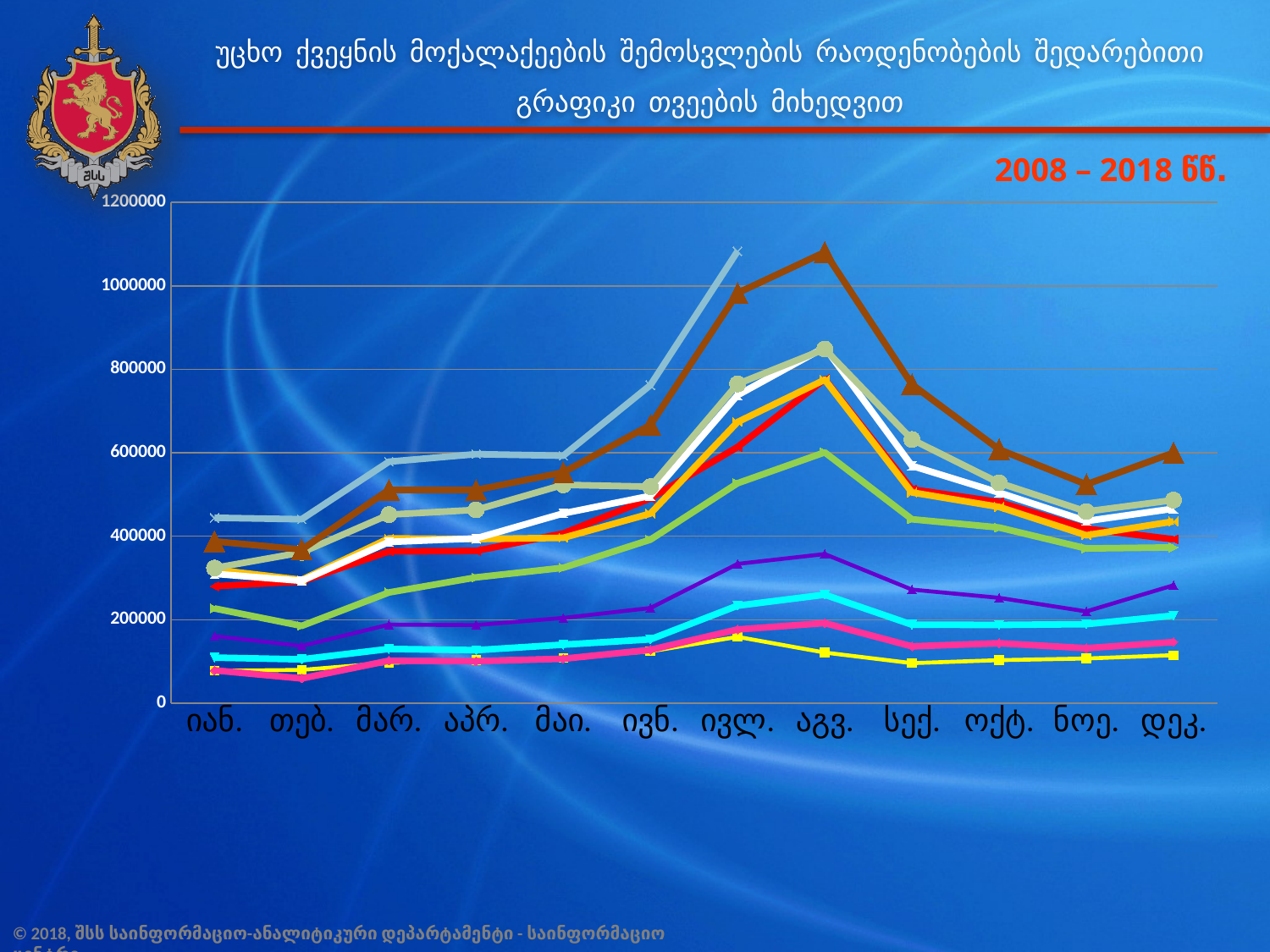
Is the value of the cyan line in აგვ. greater or less than 200000? greater In which month does the yellow line reach its highest point? ივლ. Is the value of the purple line in აგვ. greater or less than 400000? less What is the highest value shown on the y axis of the chart? 1200000 Is the value of the yellow line in აგვ. greater or less than 200000? less Does the dark brown line with triangle markers rise or fall from აგვ. to ნოე.? fall How many months are shown along the x axis of the chart? 12 What year range is printed above the chart? 2008 – 2018 წწ. In აგვ., which is larger: the dark brown line with triangle markers or the yellow line? the dark brown line In which month does the dark brown line with triangle markers reach its highest point? აგვ. What kind of chart is shown on the slide? line chart